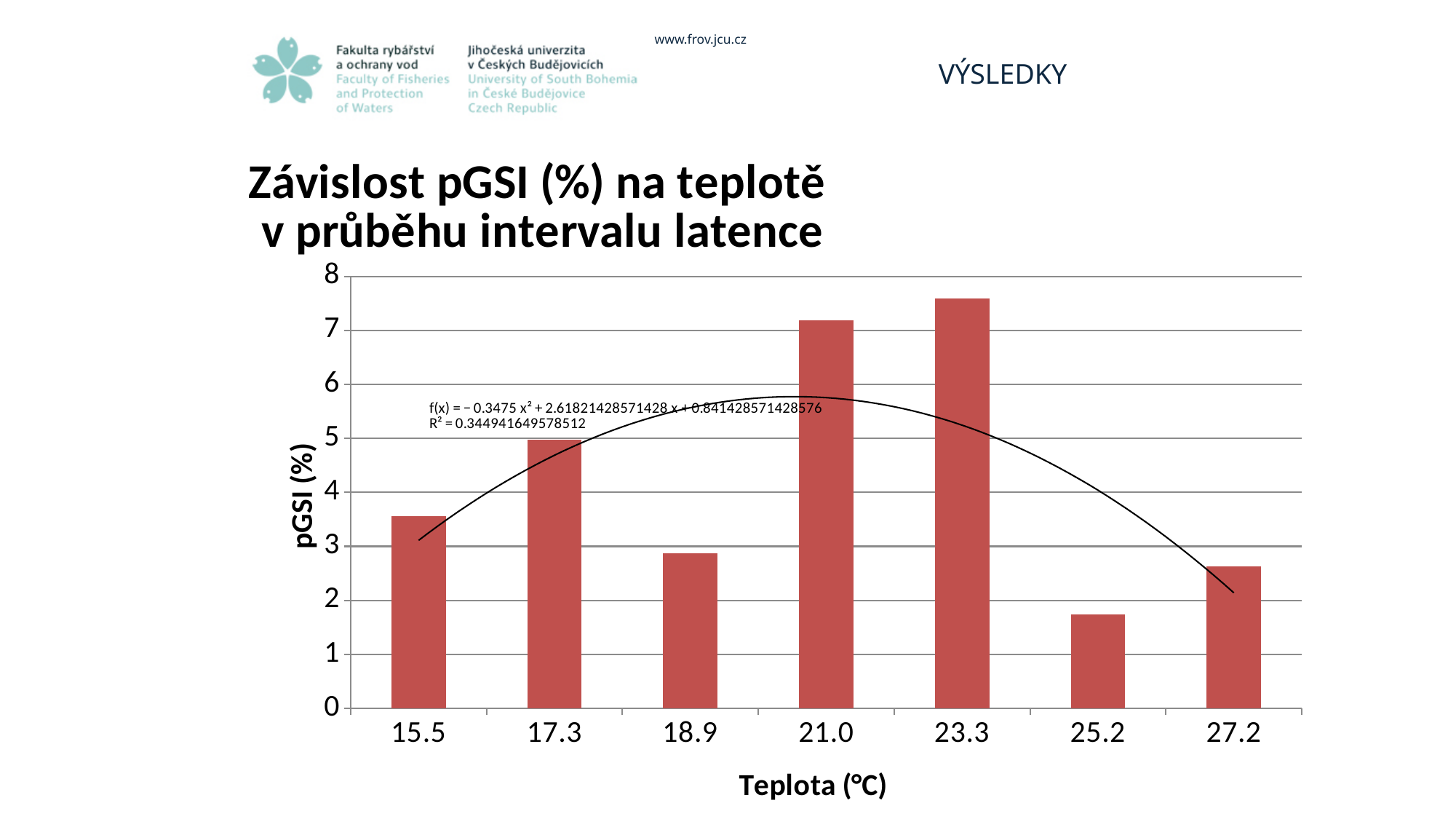
Is the pGSI value for 18.9 °C greater or less than 4? less Is the pGSI value for 15.5 °C greater or less than 3? greater How many temperature categories are shown on the x axis? 7 Which temperature has the highest pGSI (%) value? 23.3 Is the pGSI value for 21.0 °C greater or less than 7? greater What is the label of the x axis? Teplota (°C) Which has the larger pGSI value, 21.0 °C or 18.9 °C? 21.0 Which temperature has the lowest pGSI (%) value? 25.2 What kind of chart is shown on the slide? bar chart Which has the larger pGSI value, 15.5 °C or 27.2 °C? 15.5